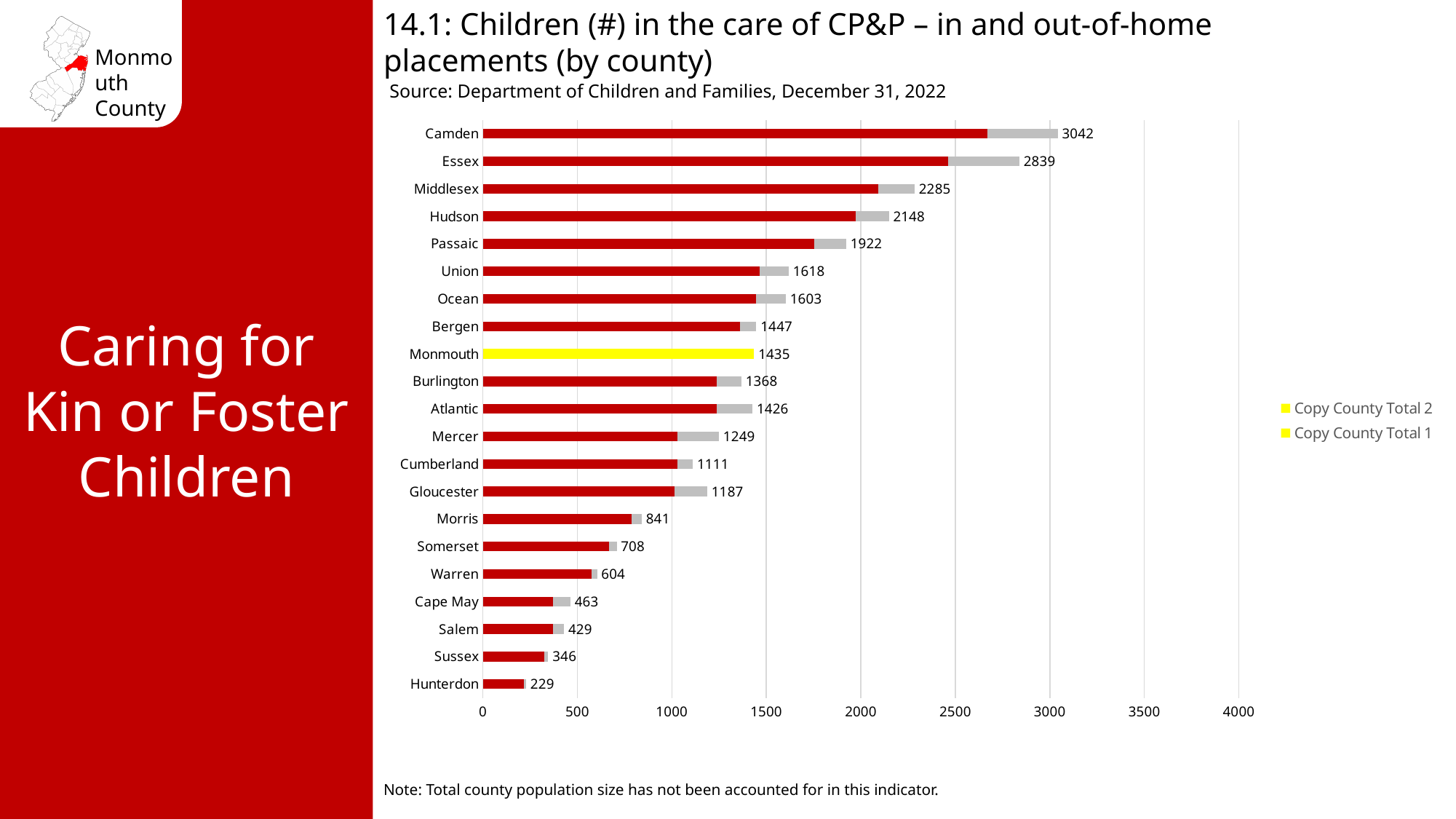
What is the total value shown for Monmouth County? 1435 Which county has the highest total number of children in the care of CP&P? Camden Which has a larger total, Atlantic or Burlington? Atlantic What is the difference between the totals for Camden and Essex? 203 What kind of chart is shown on the slide? bar chart How many series does the legend list? 2 How many counties are shown in the chart? 21 What is the total value shown for Hunterdon County? 229 What is the difference between the totals for Bergen and Monmouth? 12 What is the total number of children in the care of CP&P for Camden County? 3042 Is the red segment of the Camden bar greater or less than 2500? greater Which county has the lowest total number of children in the care of CP&P? Hunterdon